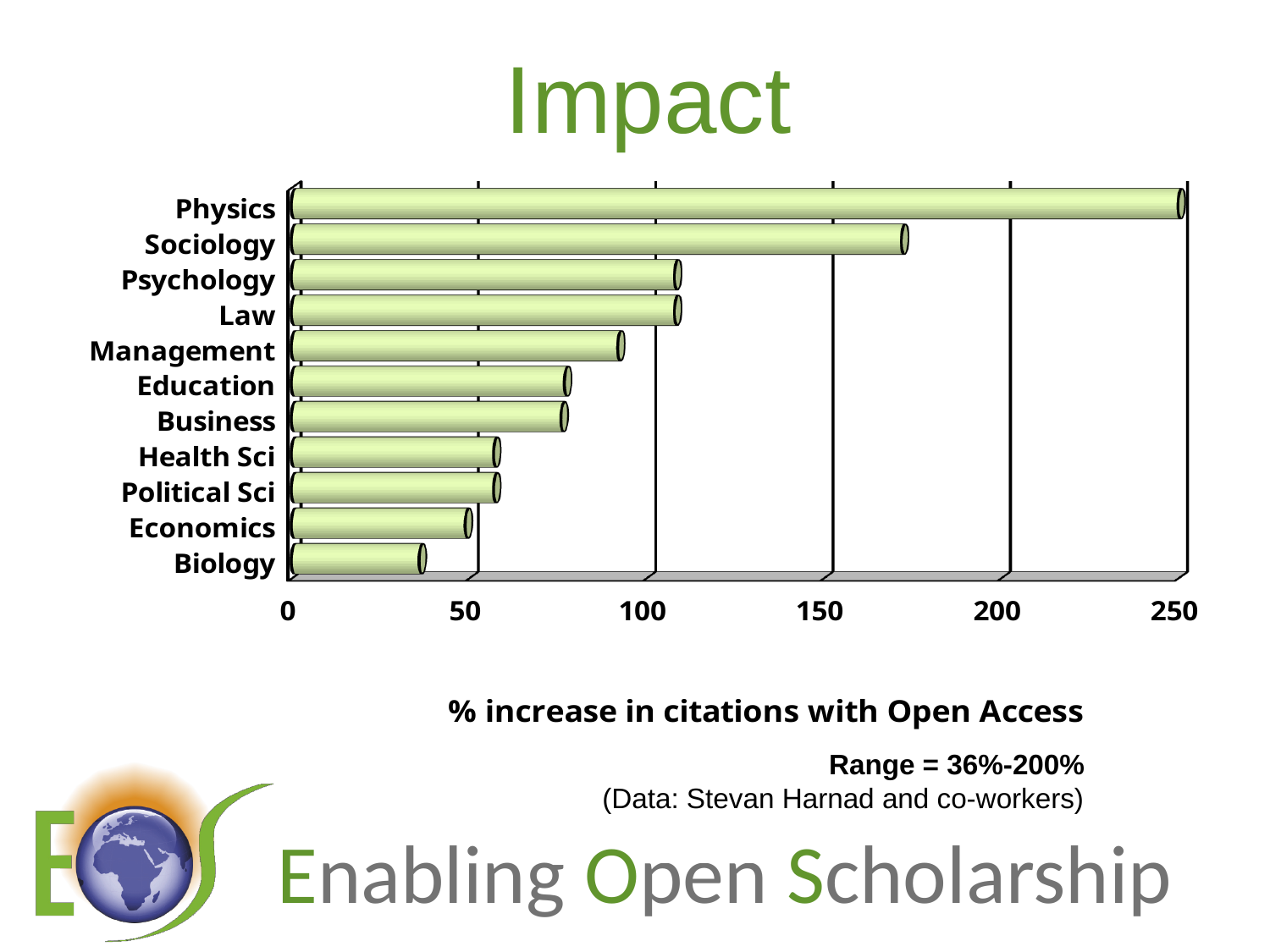
How many disciplines are plotted in the chart? 11 What quantity does the chart measure, according to the caption below it? % increase in citations with Open Access Is the value for Psychology greater or less than 100? greater Which has a larger value, Management or Education? Management Is the value for Sociology greater or less than 150? greater What kind of chart is shown on the slide? bar chart Which has a larger value, Sociology or Psychology? Sociology Is the value for Education greater or less than 100? less Which discipline has the highest % increase in citations with Open Access? Physics Which discipline has the lowest % increase in citations with Open Access? Biology